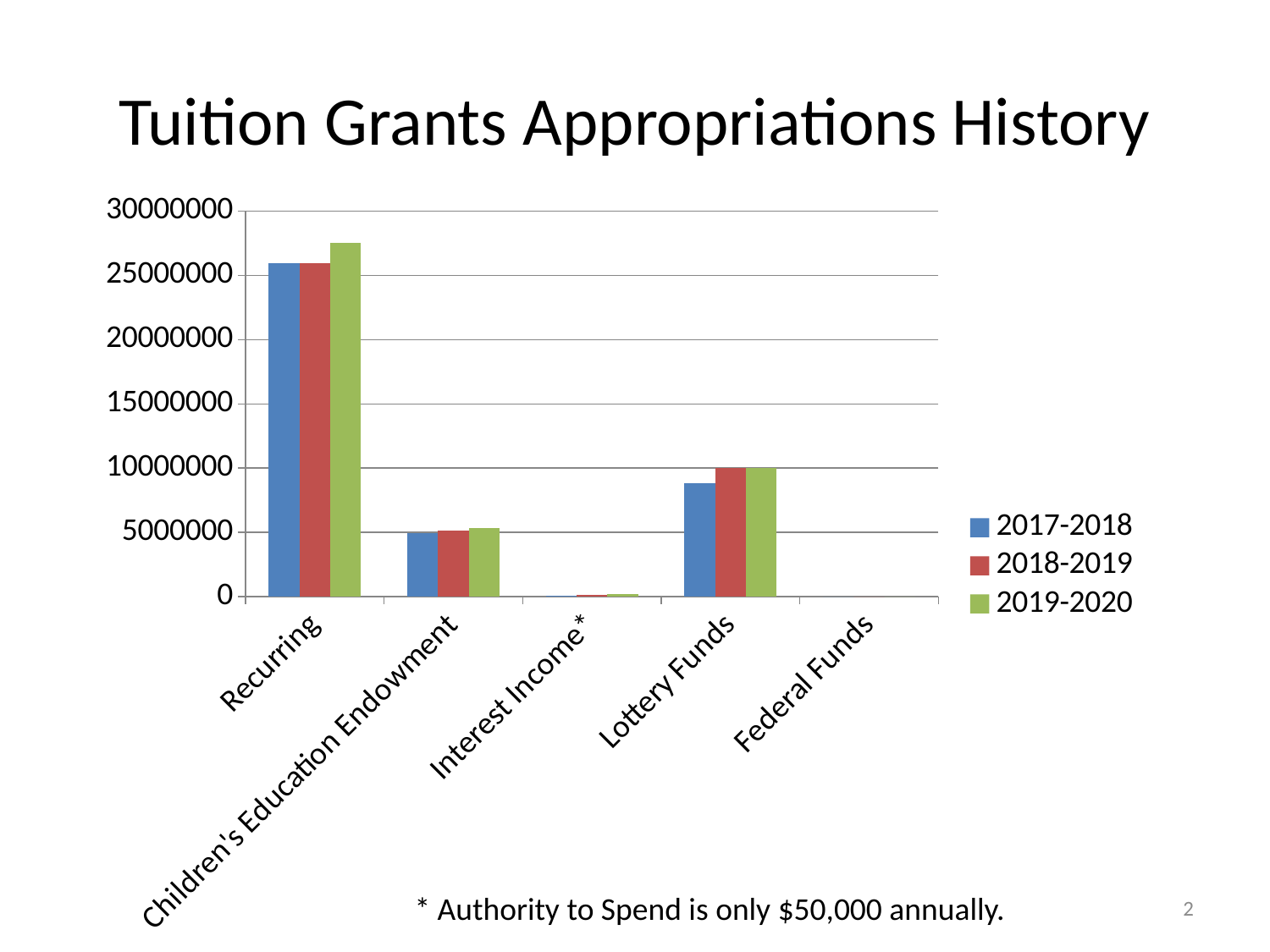
Which category has the highest value for 2019-2020? Recurring Is the value for Recurring in 2019-2020 greater or less than 25000000? greater Is the value for Recurring in 2017-2018 greater or less than 25000000? greater Which colour represents the 2019-2020 series in the legend? green Is the value for Children's Education Endowment in 2019-2020 greater or less than 10000000? less For Recurring, which is larger: the 2017-2018 value or the 2019-2020 value? 2019-2020 How many categories are shown on the x axis? 5 For 2017-2018, which is larger: Lottery Funds or Children's Education Endowment? Lottery Funds What kind of chart is shown on the slide? bar chart How many series does the legend list? 3 What is the title of the chart? Tuition Grants Appropriations History